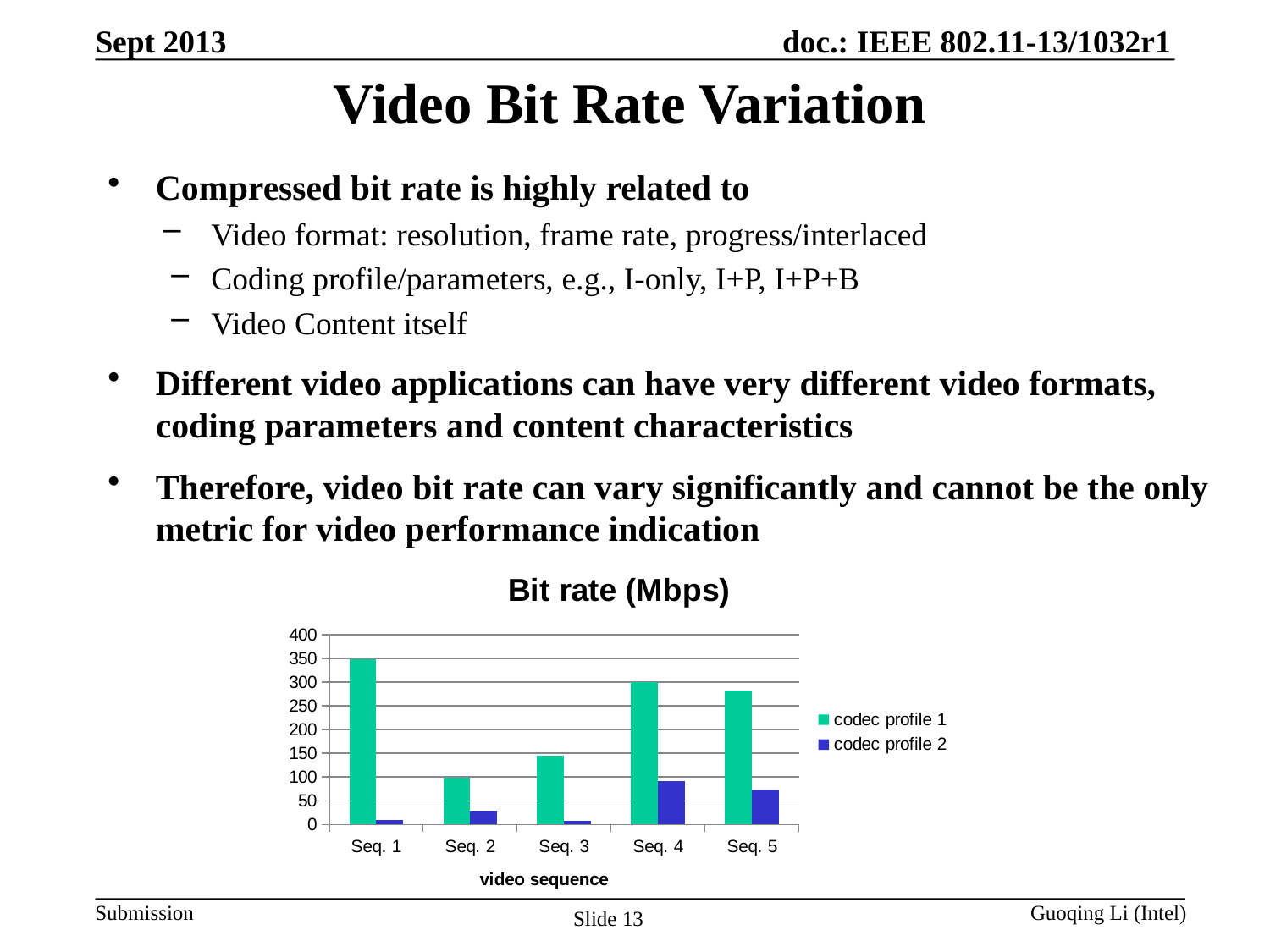
What is the label of the x axis of the chart? video sequence Is the codec profile 1 bit rate for Seq. 1 greater or less than 300? greater How many series does the chart legend list? 2 What is the title of the chart? Bit rate (Mbps) What kind of chart is shown on the slide? bar chart Which video sequence has the highest bit rate for codec profile 2? Seq. 4 Is the codec profile 2 bit rate for Seq. 4 greater or less than 100? less Is the codec profile 1 bit rate for Seq. 2 greater or less than 150? less How many video sequences are shown on the x axis of the chart? 5 For Seq. 3, which series has the larger bit rate, codec profile 1 or codec profile 2? codec profile 1 Which video sequence has the lowest bit rate for codec profile 1? Seq. 2 Which video sequence has the highest bit rate for codec profile 1? Seq. 1